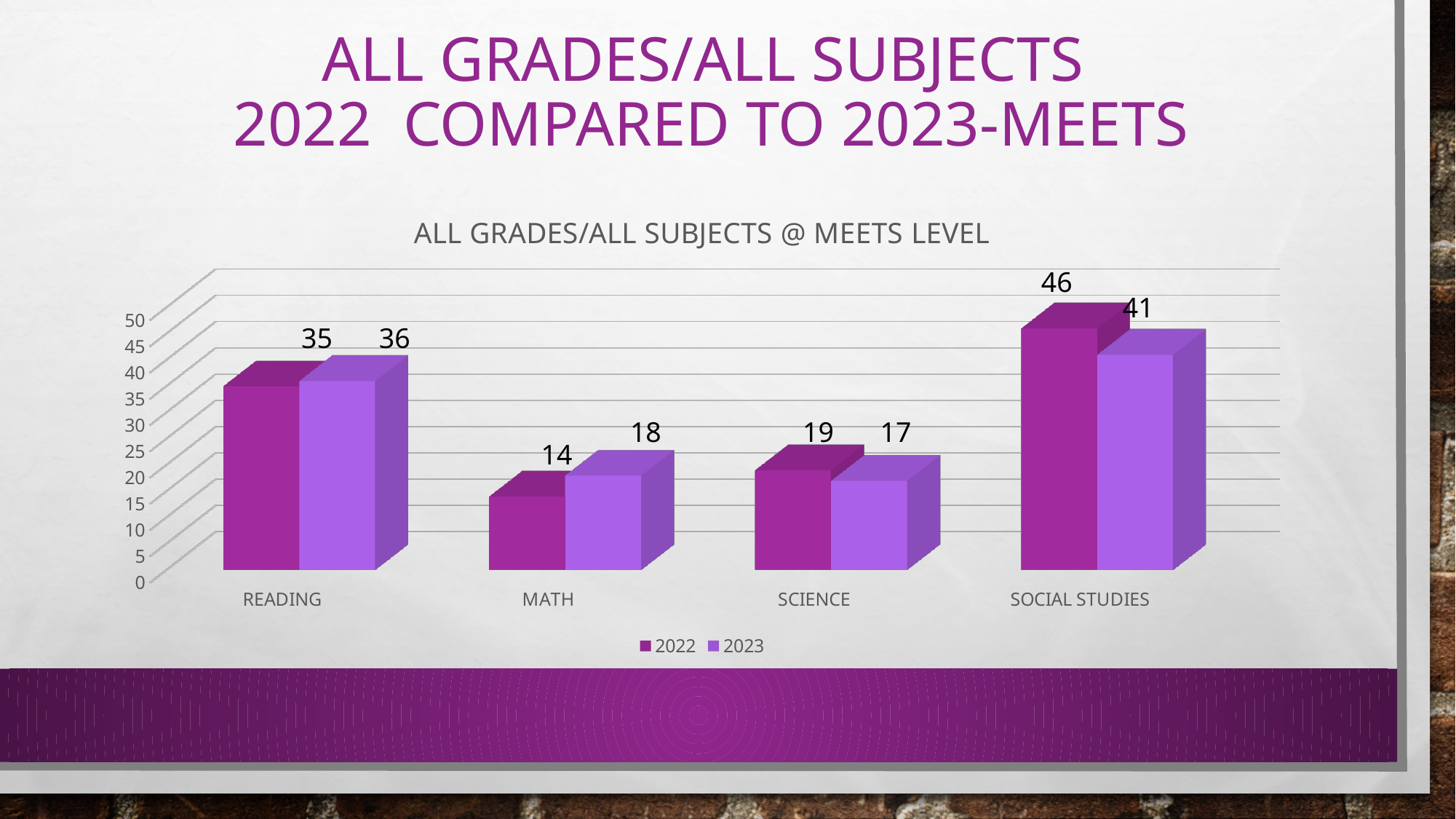
What kind of chart is shown? Bar chart What is the title of the chart? ALL GRADES/ALL SUBJECTS @ MEETS LEVEL What is the difference between the 2022 and 2023 values for Social Studies? 5 What is the 2023 value for Math? 18 Which subject has the lowest 2022 value? Math Which subject has the highest 2023 value? Social Studies Which is larger for Math, the 2022 value or the 2023 value? 2023 What is the 2022 value for Social Studies? 46 How many series does the legend list? 2 What is the 2023 value for Science? 17 How many subjects are shown on the x axis? 4 What is the 2022 value for Reading? 35